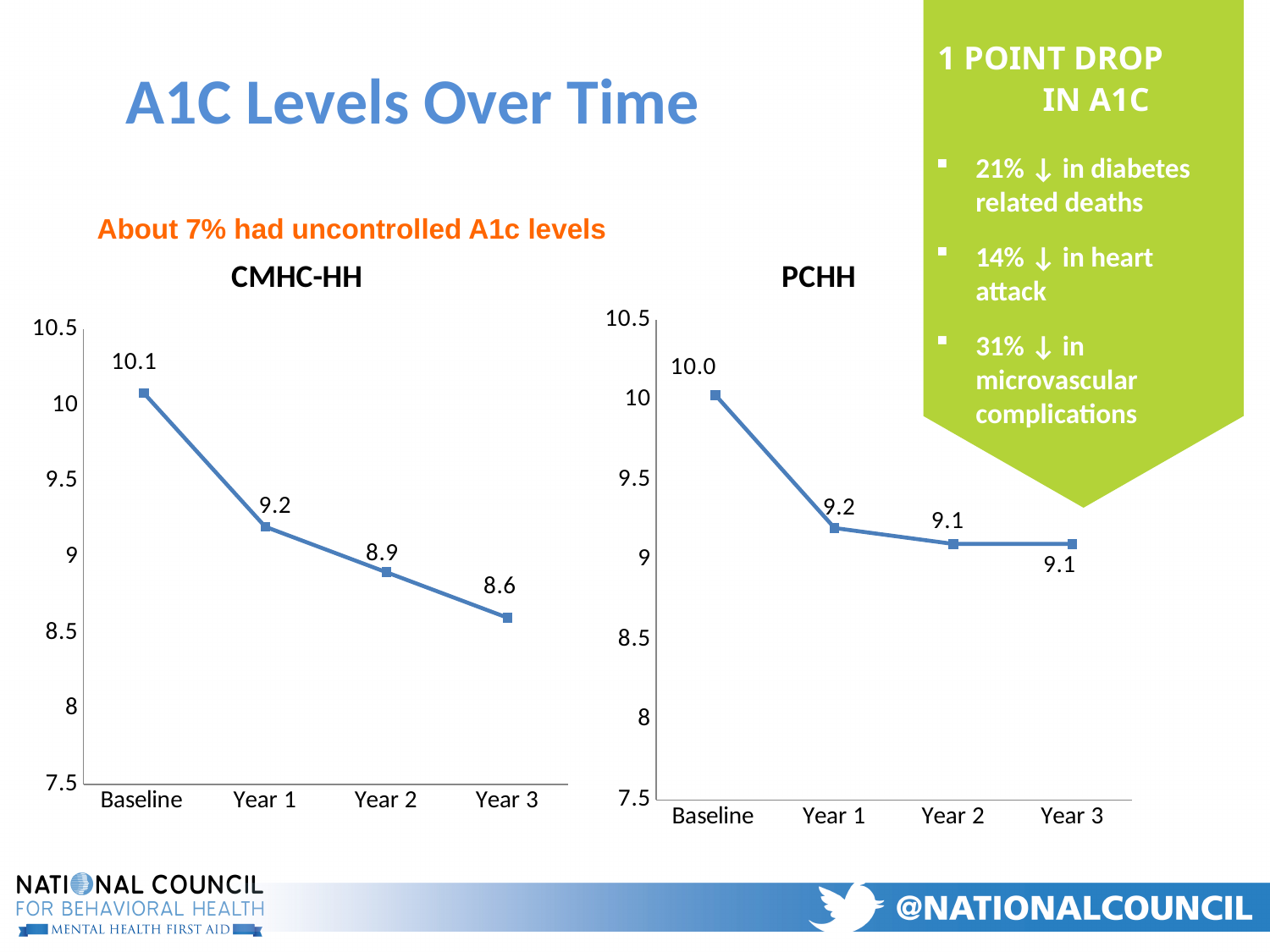
In the PCHH chart, what is the difference between the Baseline and Year 1 values? 0.8 In the PCHH chart, what is the A1c value at Baseline? 10.0 In the CMHC-HH chart, which time point has the lowest A1c value? Year 3 In the PCHH chart, which time point has the highest A1c value? Baseline In the CMHC-HH chart, do the values rise or fall from Baseline to Year 3? Fall In the CMHC-HH chart, what is the A1c value at Year 3? 8.6 In the CMHC-HH chart, what is the A1c value at Baseline? 10.1 In the CMHC-HH chart, what is the difference between the Baseline and Year 3 values? 1.5 What kind of chart is the PCHH chart? Line chart In the CMHC-HH chart, how many time points are plotted? 4 In the PCHH chart, what is the A1c value at Year 2? 9.1 Which is larger: the Year 3 value in the CMHC-HH chart or the Year 3 value in the PCHH chart? PCHH